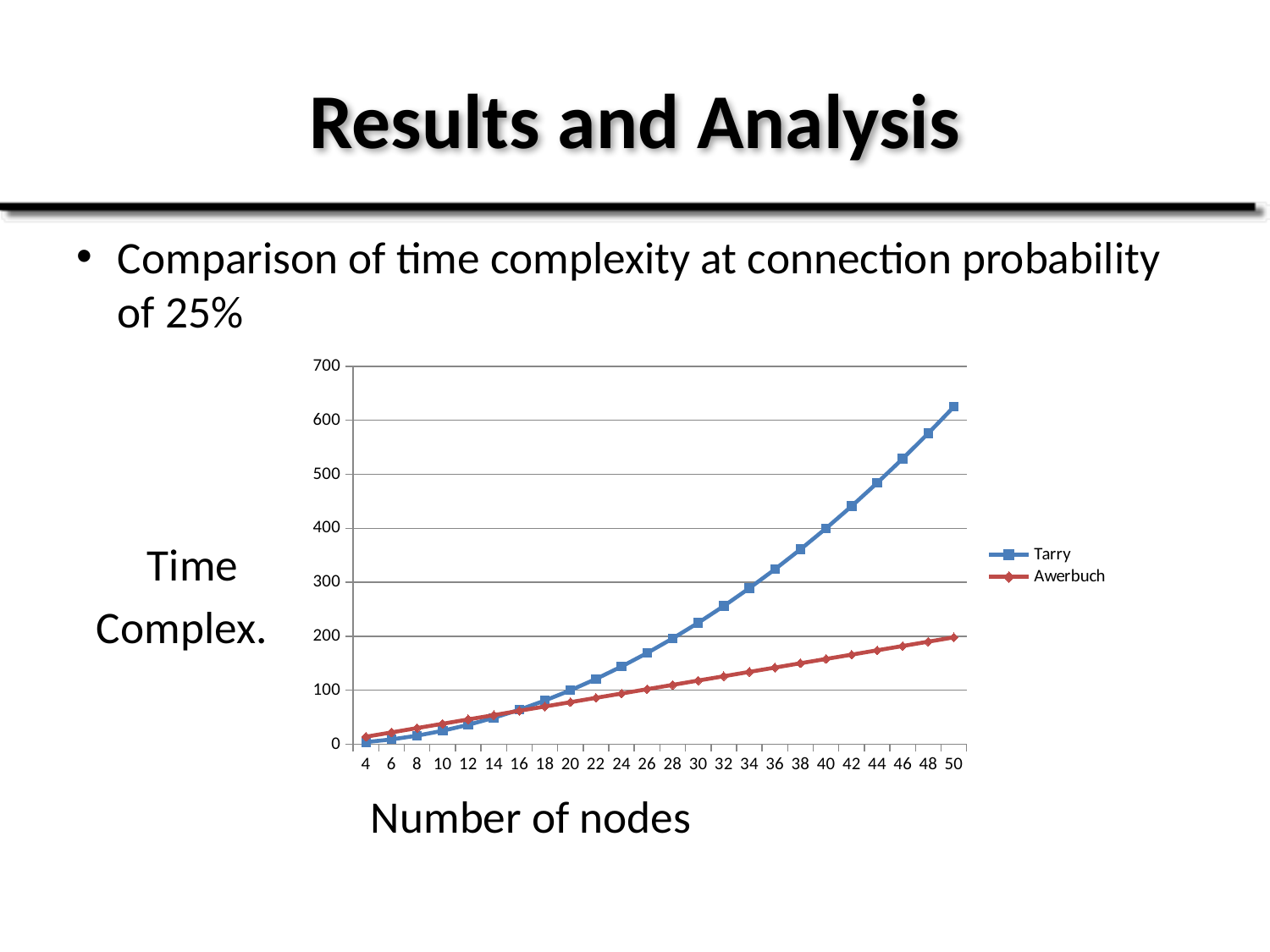
At 50 nodes, which series has the larger value, Tarry or Awerbuch? Tarry How many series does the legend list? 2 Is the value for Awerbuch at 20 nodes greater or less than 100? less What is the label of the x axis? Number of nodes What kind of chart is shown on the slide? line chart Is the value for Tarry at 26 nodes greater or less than 200? less Which two series are listed in the legend? Tarry and Awerbuch At 10 nodes, which series has the larger value, Tarry or Awerbuch? Awerbuch How many data points are plotted along the x axis for each series? 24 Do the values for Tarry rise or fall as the number of nodes increases? rise Is the value for Tarry at 50 nodes greater or less than 600? greater